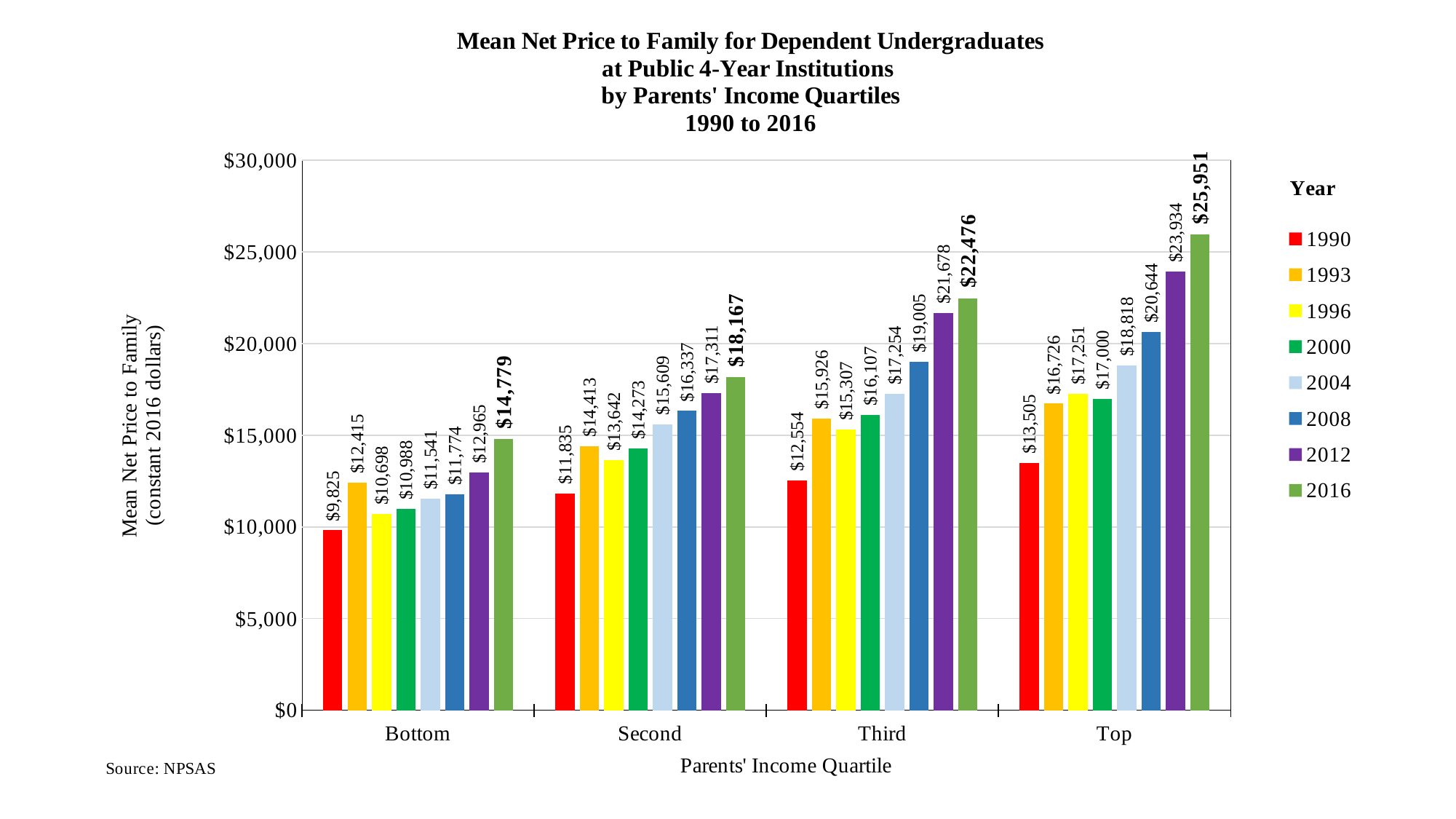
Which income quartile has the highest mean net price in 2016? Top What is the difference between the 2016 and 1990 mean net price for the Top income quartile? $12,446 How many years does the legend list? 8 Which is larger: the 2004 value for the Second quartile or the 2004 value for the Third quartile? Third quartile ($17,254) What is the mean net price to family for the Third income quartile in 2008? $19,005 What kind of chart is shown on the slide? Bar chart Within the Top income quartile, do the values generally rise or fall from 1990 to 2016? Rise Which income quartile has the lowest mean net price in 1990? Bottom What is the mean net price to family for the Top income quartile in 1990? $13,505 What is the mean net price to family for the Bottom income quartile in 2016? $14,779 How many income quartile categories are shown on the x axis? 4 Is the 2012 value for the Top income quartile greater or less than $20,000? greater